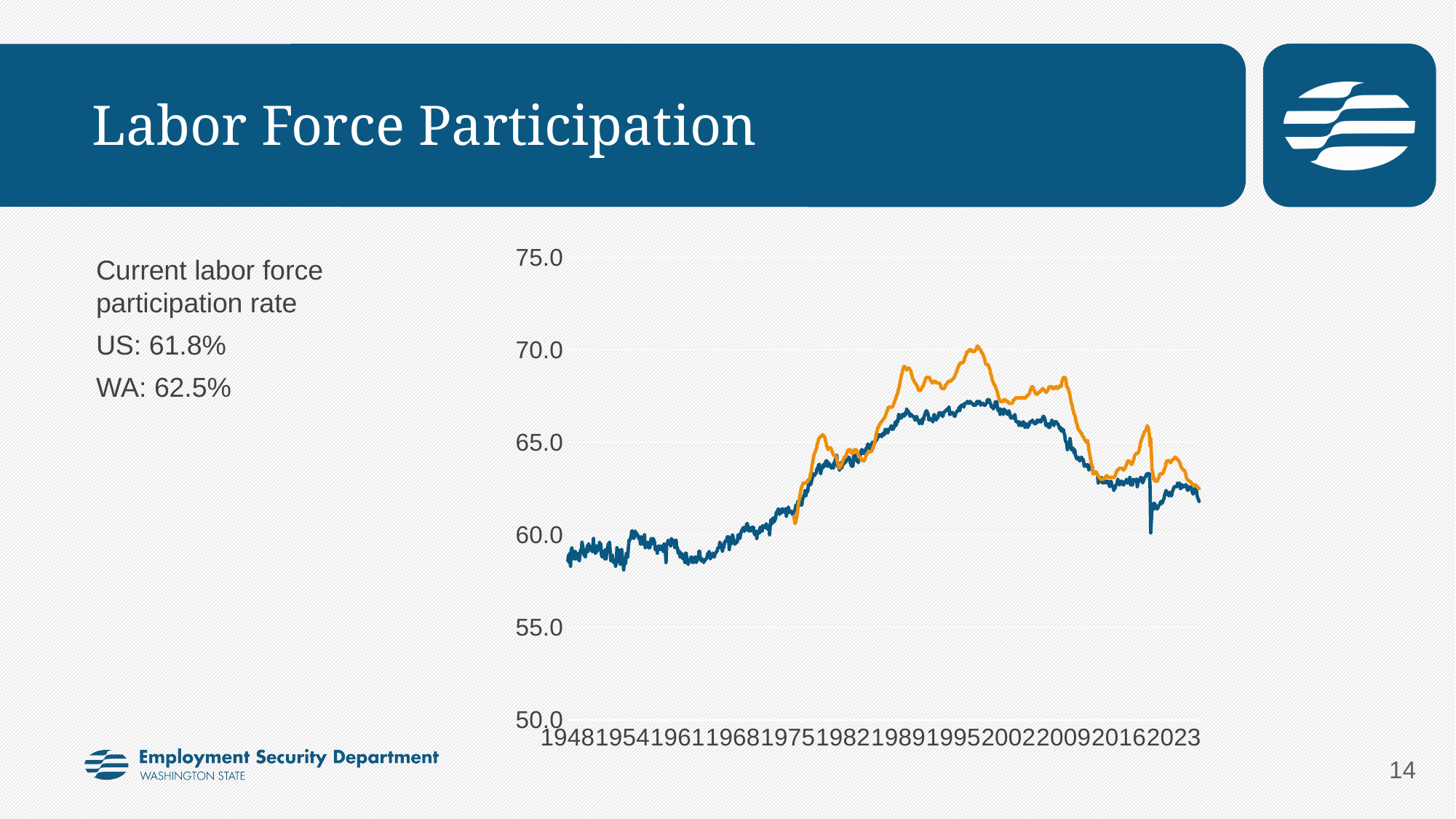
How many lines are plotted on the chart? 2 What kind of chart is shown on the slide? line chart What is the highest value shown on the y axis of the chart? 75.0 Is the value of the blue line at the end of the chart (2023) greater or less than 65.0? less Around 1995, which line is higher, the orange line or the blue line? the orange line Is the value of the blue line at the start of the chart (1948) greater or less than 60.0? less What is the first year shown on the x axis of the chart? 1948 Is the value of the blue line around 2000 greater or less than 65.0? greater Does the blue line generally rise or fall between 1948 and 2000? rise Which line begins earlier on the x axis, the blue line or the orange line? the blue line Does the blue line generally rise or fall between 2000 and 2023? fall